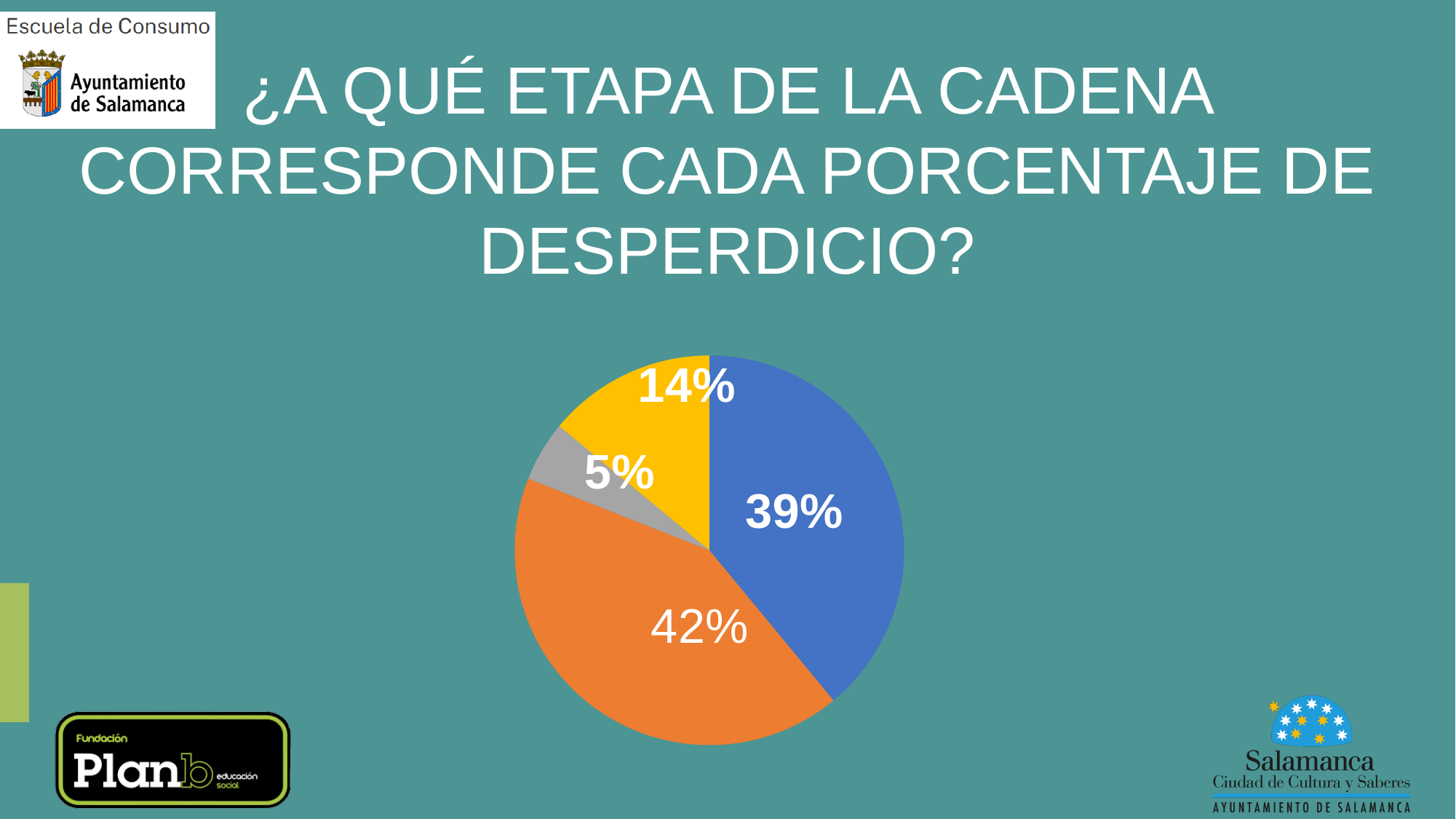
What percentage is shown on the grey slice of the pie chart? 5% What kind of chart is shown on the slide? pie chart What percentage is shown on the blue slice of the pie chart? 39% How many slices does the pie chart have? 4 Which colour slice represents the smallest share of the pie chart? grey What is the difference in percentage points between the yellow slice and the grey slice? 9 What percentage is shown on the orange slice of the pie chart? 42% What percentage is shown on the yellow slice of the pie chart? 14% What is the difference in percentage points between the orange slice and the blue slice? 3 Does the pie chart include a legend naming the slices? No Which colour slice represents the largest share of the pie chart? orange Which is larger, the yellow slice or the grey slice? yellow